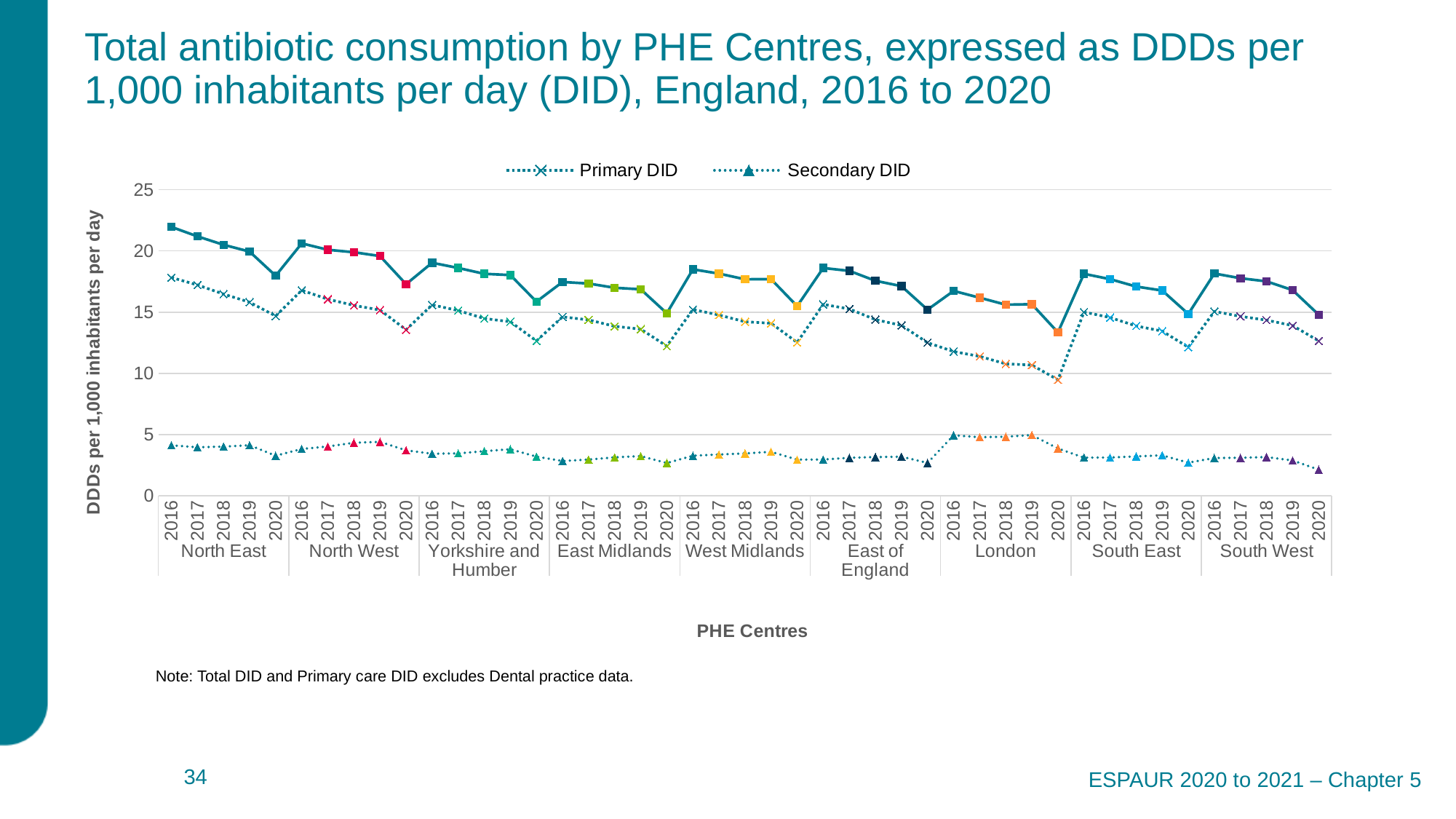
Does the Primary DID for London rise or fall from 2016 to 2019? fall Is the Secondary DID value for South West in 2020 greater or less than 5? less How many series does the legend list? 2 Is the Primary DID value for West Midlands in 2020 greater or less than 15? less Is the Primary DID value for London in 2019 greater or less than 15? less How many PHE Centres are shown along the x axis? 9 What is the label of the y axis? DDDs per 1,000 inhabitants per day Which is larger for East Midlands in 2018, the Primary DID or the Secondary DID? Primary DID What kind of chart is shown on the slide? line chart Which PHE Centre has the highest Secondary DID values? London